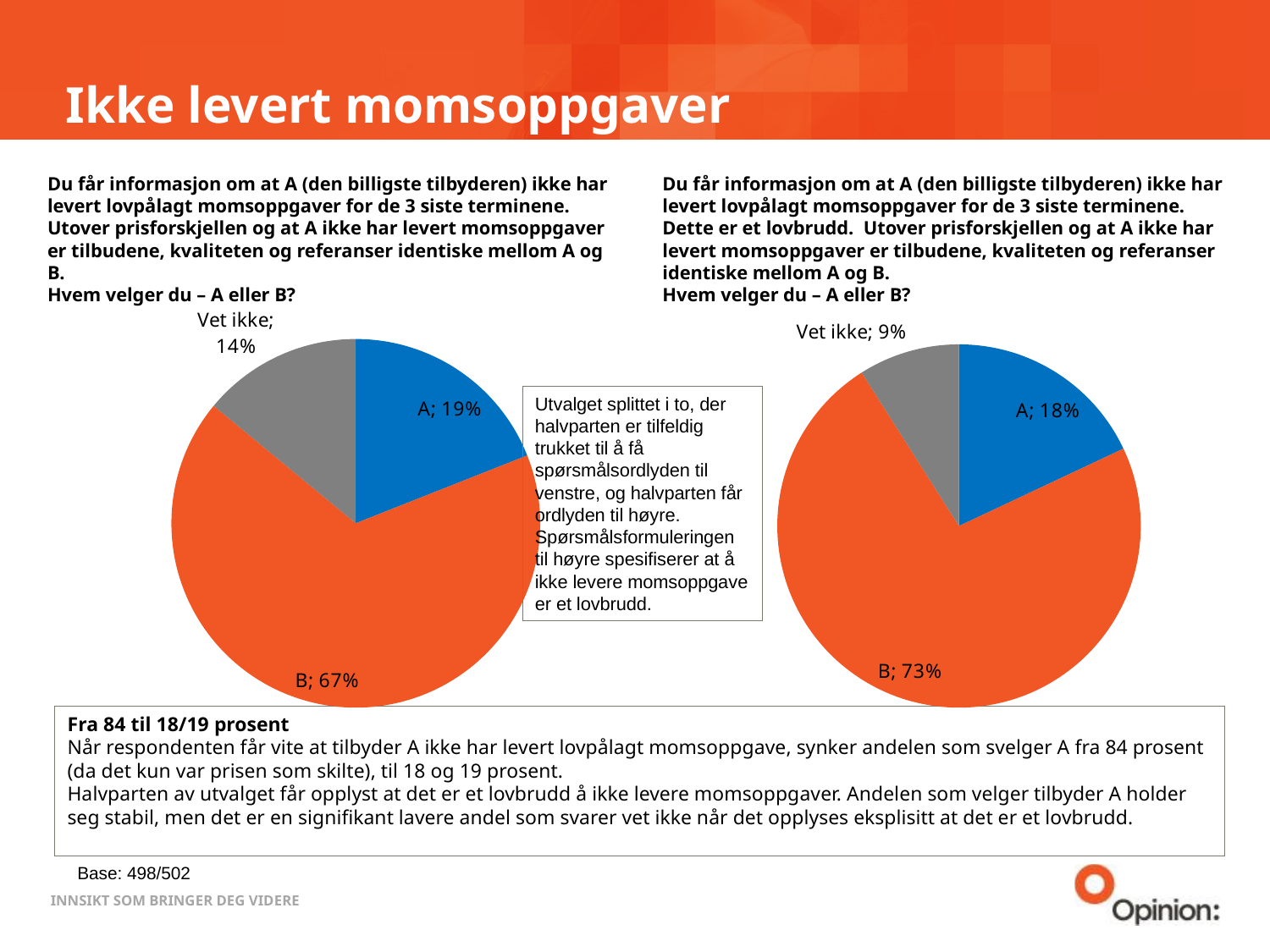
In the left pie chart, what colour is the slice for B? Orange In the left pie chart, what share of respondents chose B? 67% What is the difference between the share for B in the right pie chart and the share for B in the left pie chart? 6 percentage points In the left pie chart, which category has the largest slice? B In the left pie chart, what is the value for "Vet ikke"? 14% In the right pie chart, what share of respondents chose A? 18% In the right pie chart, which category has the smallest slice? Vet ikke In the right pie chart, what is the value for "Vet ikke"? 9% What type of chart is used on the left side of the slide? Pie chart Which is larger: the share for A in the left pie chart or the share for A in the right pie chart? Left pie chart (19%) How many slices does the right pie chart have? 3 In the left pie chart, what is the difference between the shares for B and A? 48 percentage points